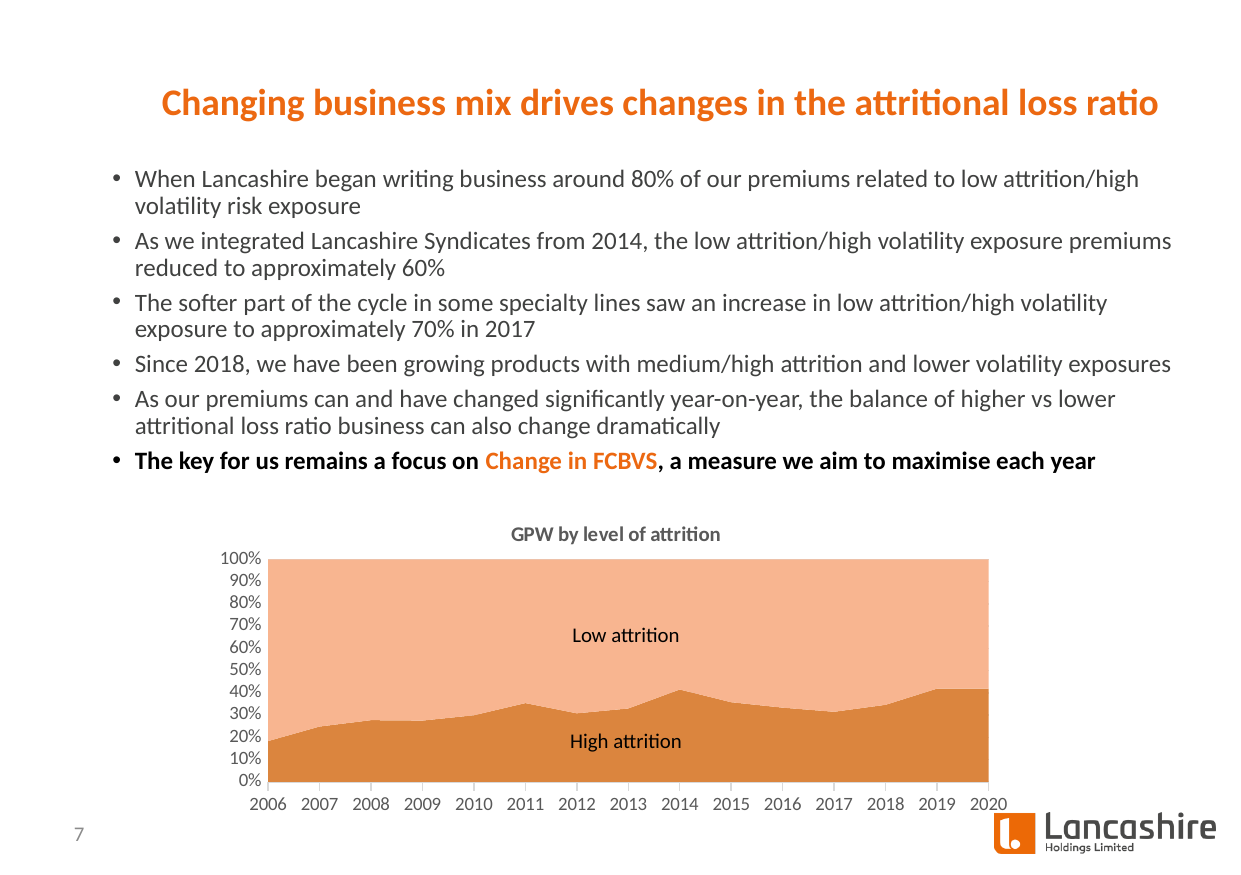
In which year is the High attrition share lowest? 2006 What kind of chart is shown on the slide? Stacked area chart What is the title of the chart? GPW by level of attrition Does the High attrition share generally rise or fall from 2006 to 2020? rise Is the High attrition share in 2011 greater or less than 30%? greater Is the High attrition share in 2006 greater or less than 20%? less Is the Low attrition share in 2006 greater or less than 80%? greater What is the first year shown on the x axis? 2006 Is the High attrition share larger in 2006 or in 2020? 2020 How many years are shown on the x axis of the chart? 15 How many series are shown in the chart? 2